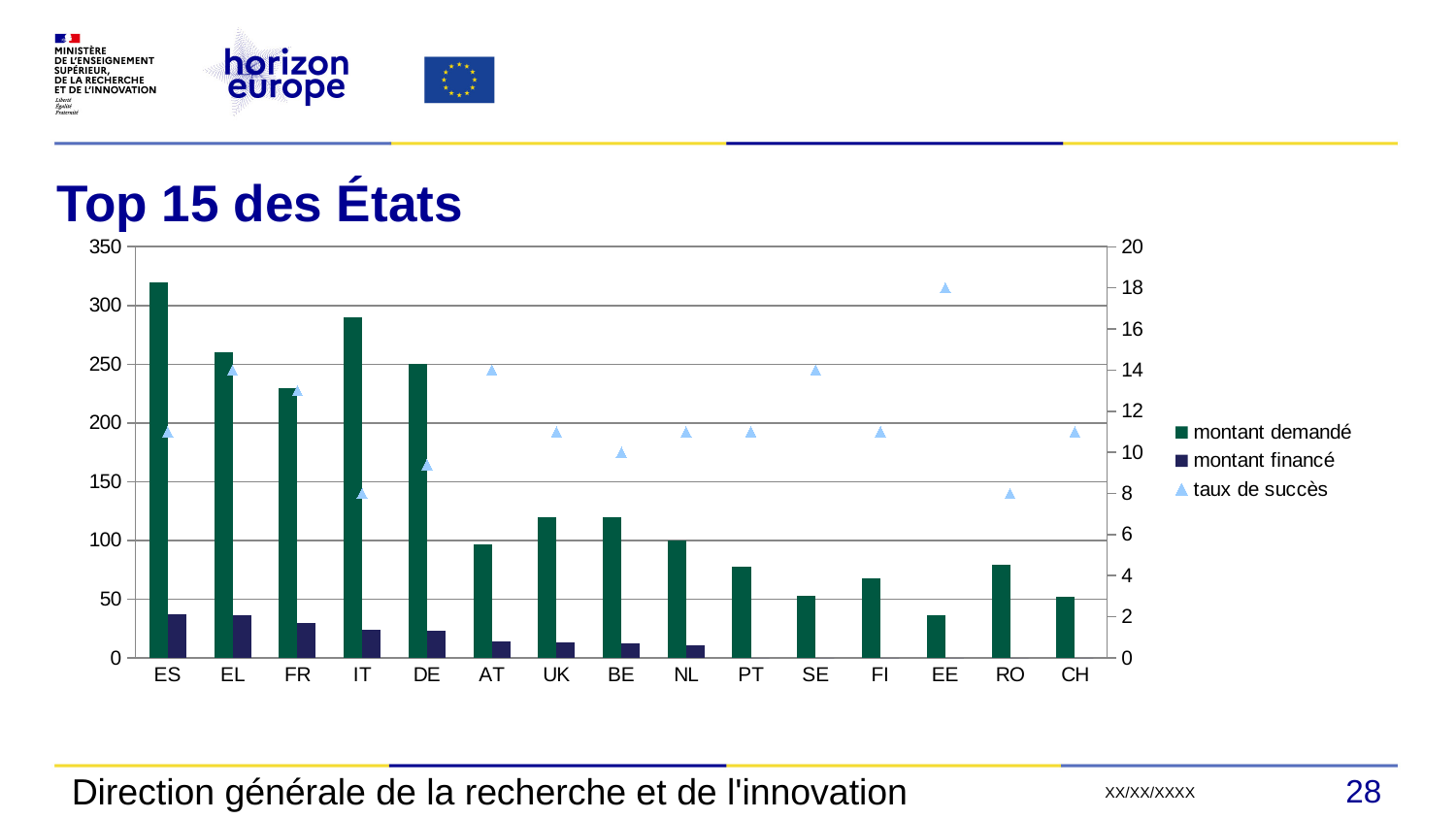
Is the 'taux de succès' for EE greater or less than 16? greater Which has a larger 'montant demandé', RO or SE? RO What is the title of the chart? Top 15 des États What kind of chart is shown on the slide? bar chart How many series does the chart's legend list? 3 Which country has the lowest 'montant demandé'? EE How many countries are shown on the x axis of the chart? 15 Is the 'montant demandé' for ES greater or less than 300? greater Which country has the highest 'taux de succès'? EE Which country has the highest 'montant demandé'? ES Which has a larger 'montant demandé', IT or EL? IT